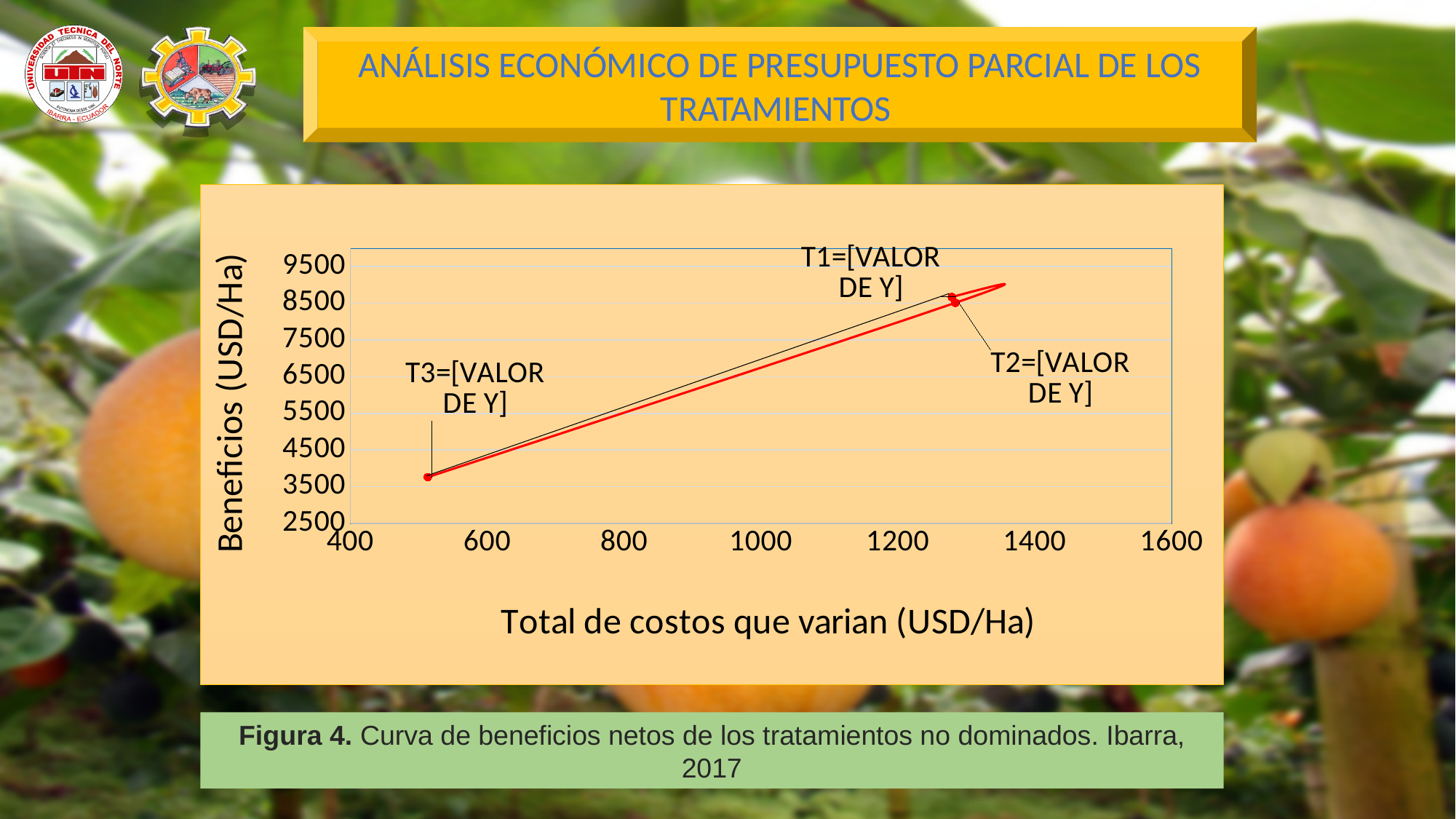
Do net benefits rise or fall as the total varying costs increase along the x axis? rise What is the title of the horizontal axis of the chart? Total de costos que varian (USD/Ha) Which treatment has a higher net benefit, T2 or T3? T2 What kind of chart is shown on the slide? line chart Which treatment has the lowest total varying cost on the chart? T3 Is the total varying cost for T3 greater or less than 600 USD/Ha? less Is the net benefit for T2 greater or less than 7500 USD/Ha? greater What is the title of the vertical axis of the chart? Beneficios (USD/Ha) Which treatment has the lowest net benefit on the chart? T3 How many treatments (data points) are labelled on the chart? 3 Is the net benefit for T3 greater or less than 4500 USD/Ha? less